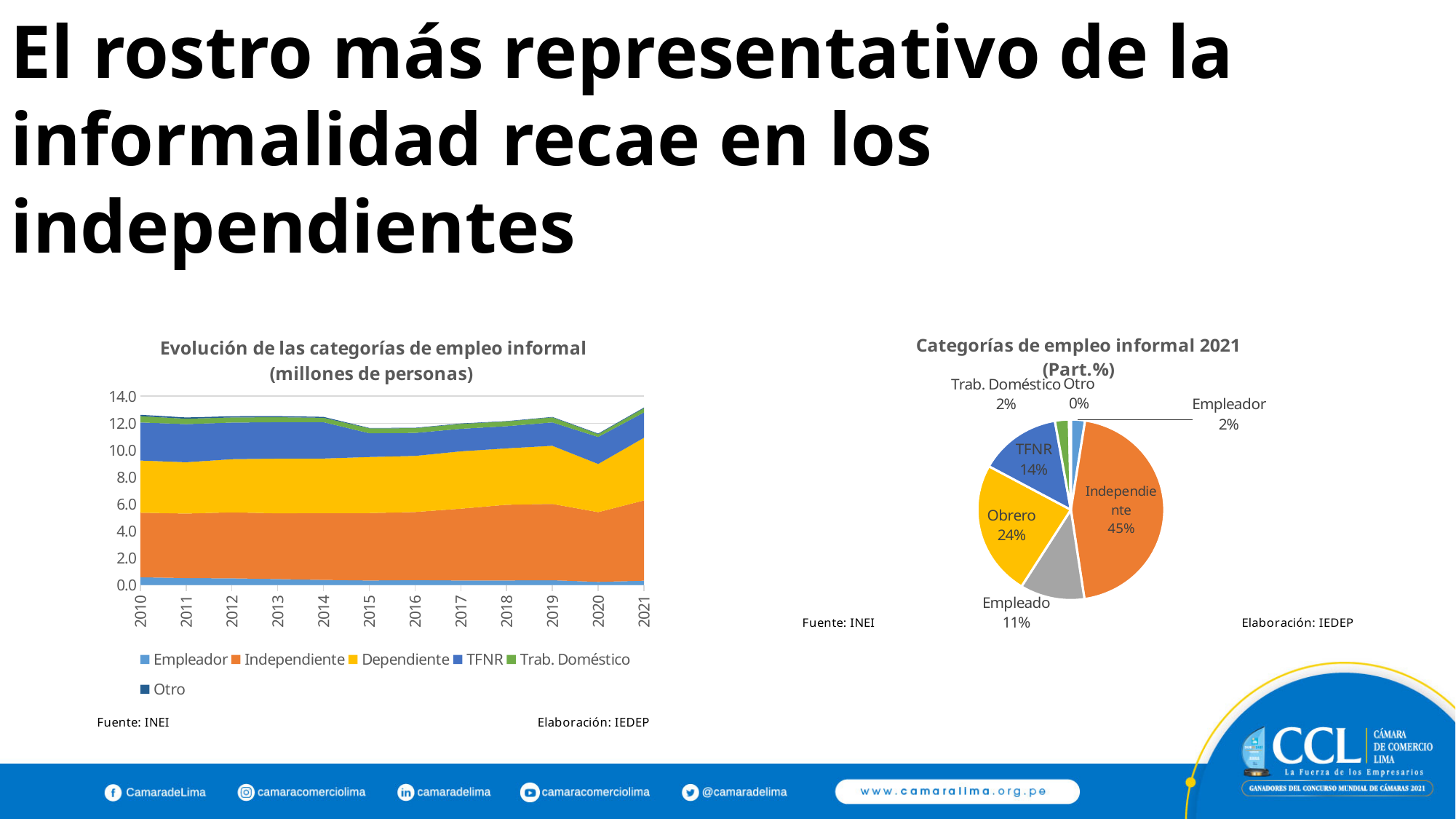
In the pie chart 'Categorías de empleo informal 2021', what share does Obrero have? 24% In the pie chart 'Categorías de empleo informal 2021', what share does TFNR have? 14% In the pie chart 'Categorías de empleo informal 2021', which category has the largest share? Independiente In the pie chart 'Categorías de empleo informal 2021', what share does Independiente have? 45% What kind of chart is 'Evolución de las categorías de empleo informal'? Stacked area chart In the pie chart 'Categorías de empleo informal 2021', which is larger, TFNR or Empleado? TFNR In the pie chart 'Categorías de empleo informal 2021', what is the difference in percentage points between Independiente and Obrero? 21 In the pie chart 'Categorías de empleo informal 2021', which category has the smallest share? Otro How many years are shown on the x axis of 'Evolución de las categorías de empleo informal'? 12 How many slices does the pie chart 'Categorías de empleo informal 2021' have? 7 How many series does the legend of 'Evolución de las categorías de empleo informal' list? 6 What kind of chart is the chart on the right of the slide? Pie chart